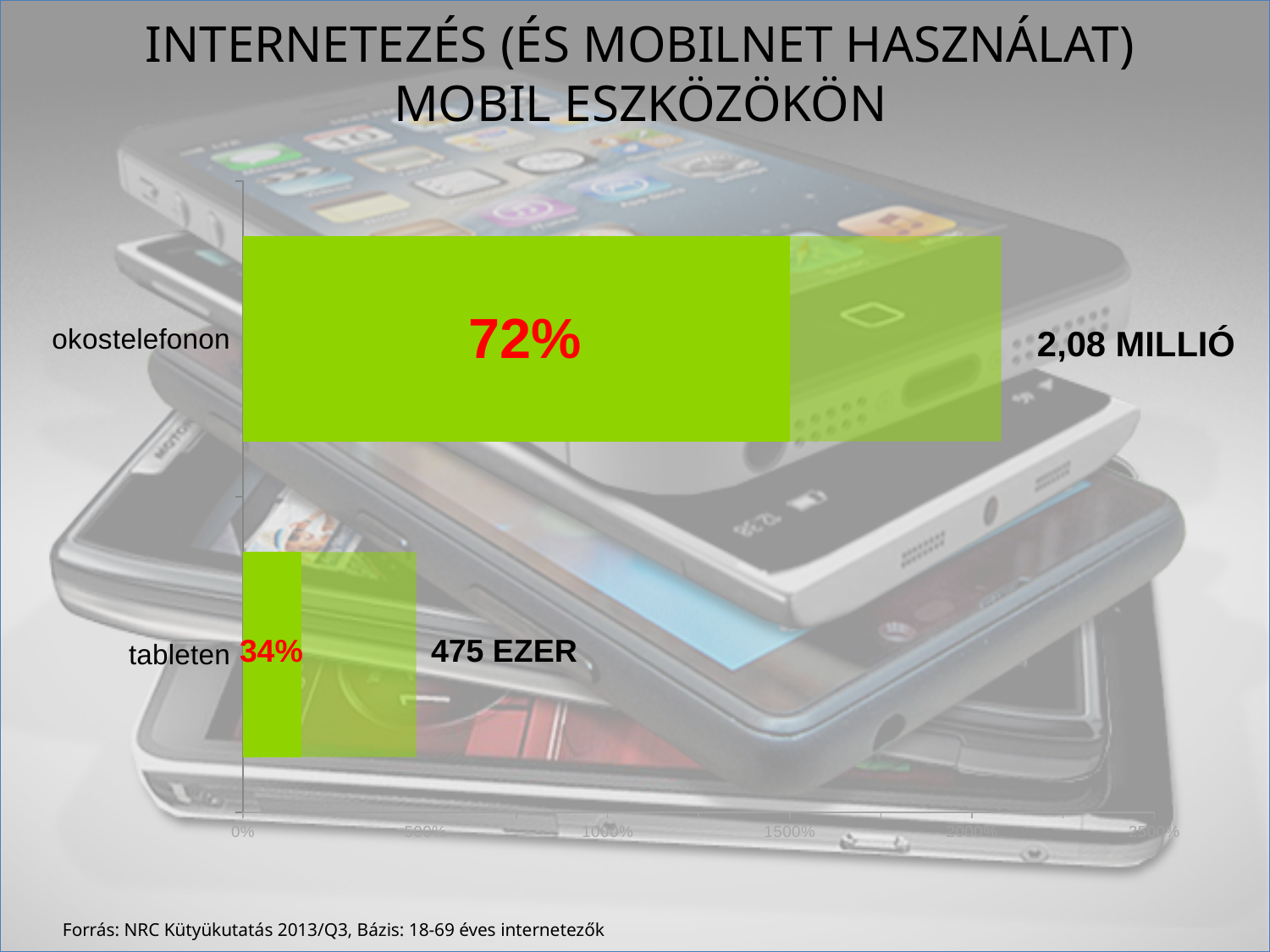
What absolute figure is printed next to the tableten bar? 475 EZER What is the title of the slide containing the chart? INTERNETEZÉS (ÉS MOBILNET HASZNÁLAT) MOBIL ESZKÖZÖKÖN Which is larger, the percentage for okostelefonon or for tableten? okostelefonon What kind of chart is shown on the slide? bar chart What percentage is shown for okostelefonon? 72% How many categories are shown in the chart? 2 What colour are the bars in the chart? green What absolute figure is printed next to the okostelefonon bar? 2,08 MILLIÓ What percentage is shown for tableten? 34% What is the difference in percentage points between okostelefonon and tableten? 38 Which category has the highest percentage? okostelefonon Which category has the lowest percentage? tableten